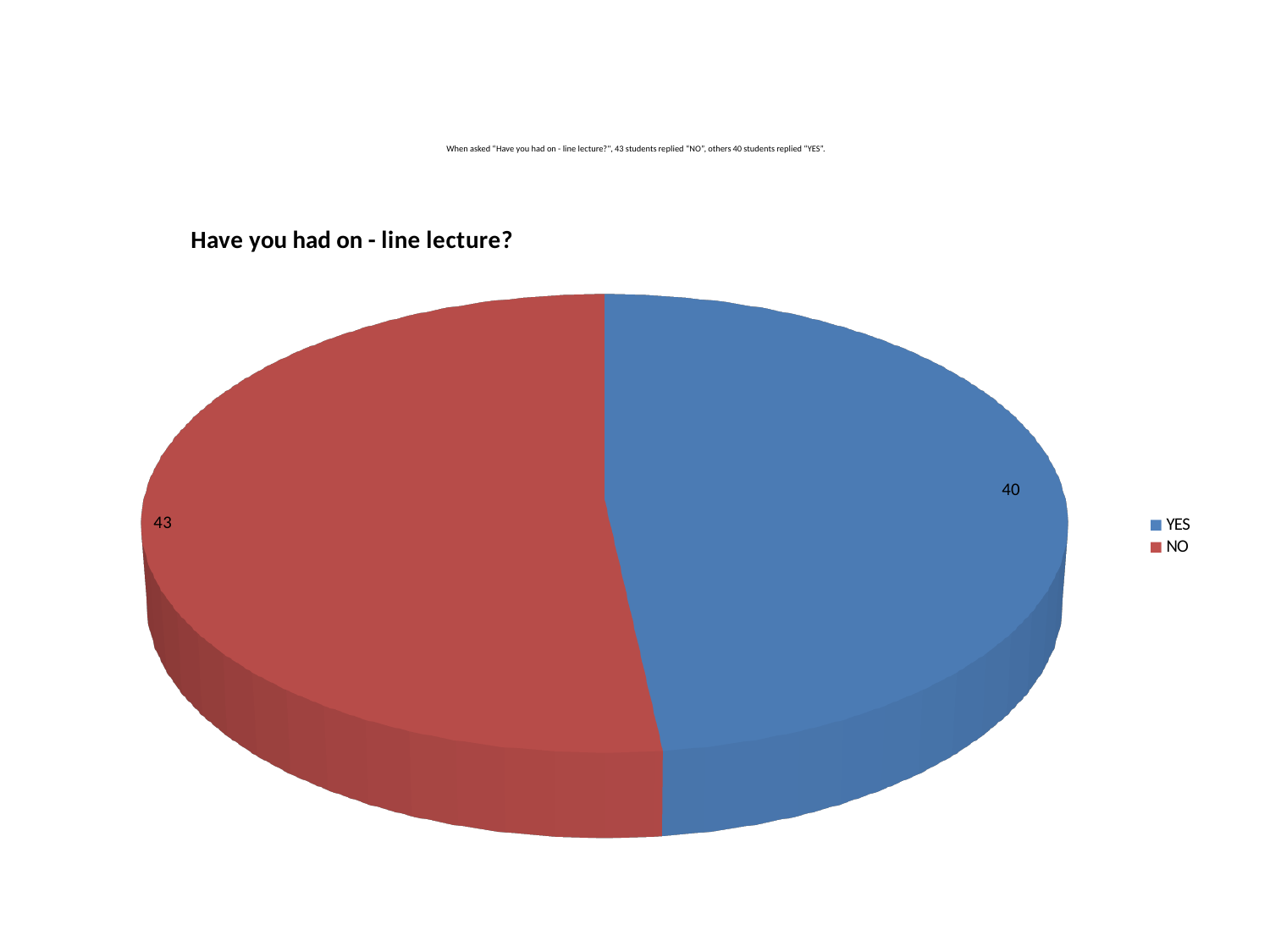
Is the value for NO larger or smaller than the value for YES? larger What is the difference between the NO and YES values in the pie chart? 3 How many slices does the pie chart have? 2 How many entries does the legend list? 2 What is the total of the two slices in the pie chart? 83 What is the value for YES in the pie chart? 40 Which category has the larger slice in the pie chart? NO What is the value for NO in the pie chart? 43 Which category has the smaller slice in the pie chart? YES What is the title of the chart? Have you had on - line lecture? What kind of chart is shown on the slide? pie chart Which colour represents YES in the pie chart? blue